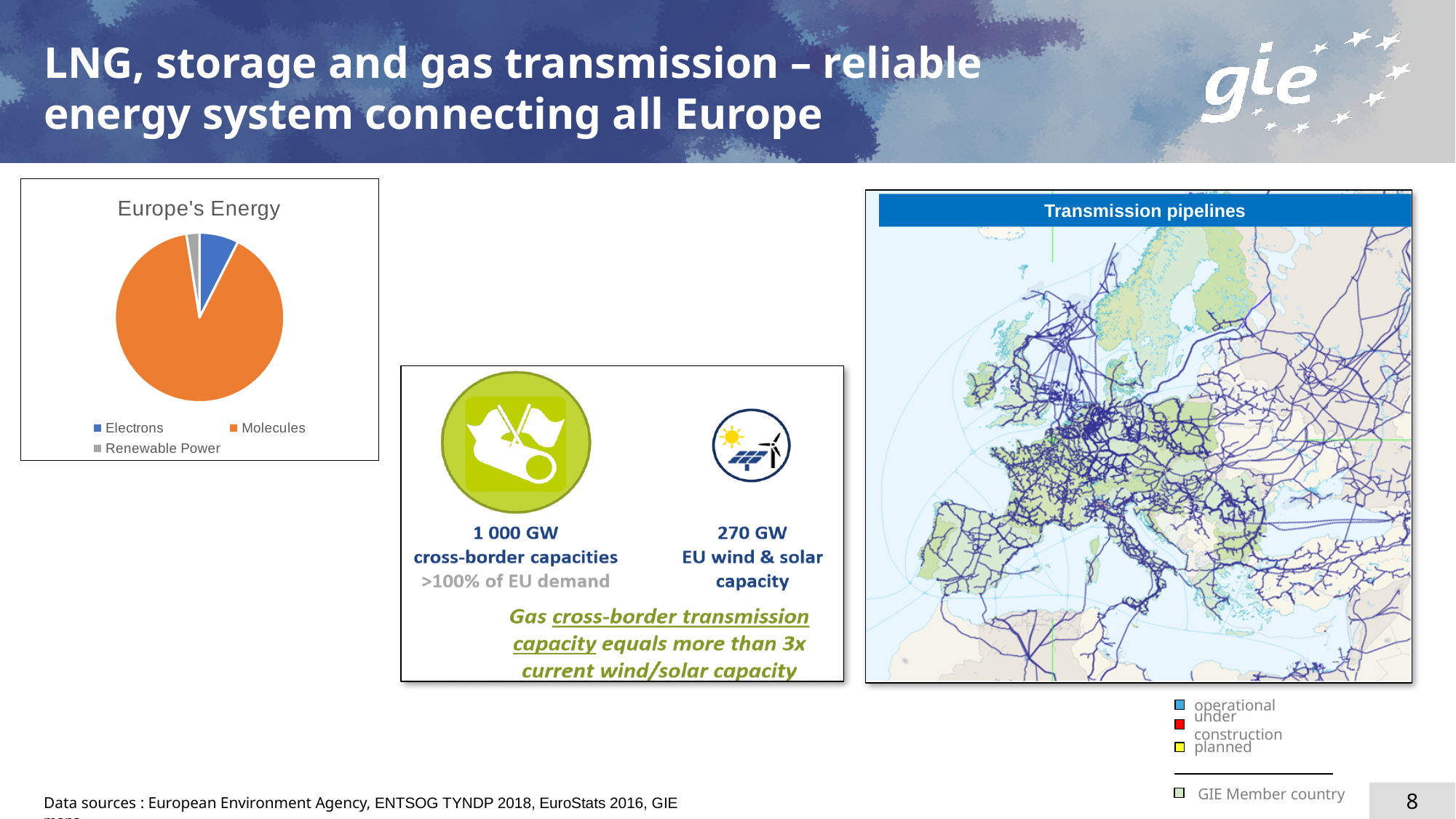
How many entries does the legend of the "Europe's Energy" pie chart list? 3 How many slices does the "Europe's Energy" pie chart have? 3 In the "Europe's Energy" pie chart, which slice is larger: Electrons or Renewable Power? Electrons What kind of chart is the "Europe's Energy" chart? pie chart What is the title of the pie chart on the left of the slide? Europe's Energy Which category has the smallest slice in the "Europe's Energy" pie chart? Renewable Power What colour is the Molecules slice in the "Europe's Energy" pie chart? orange In the "Europe's Energy" pie chart, which slice is larger: Molecules or Electrons? Molecules In the "Europe's Energy" pie chart, does the Molecules slice take up more or less than half of the pie? more Which category has the largest slice in the "Europe's Energy" pie chart? Molecules